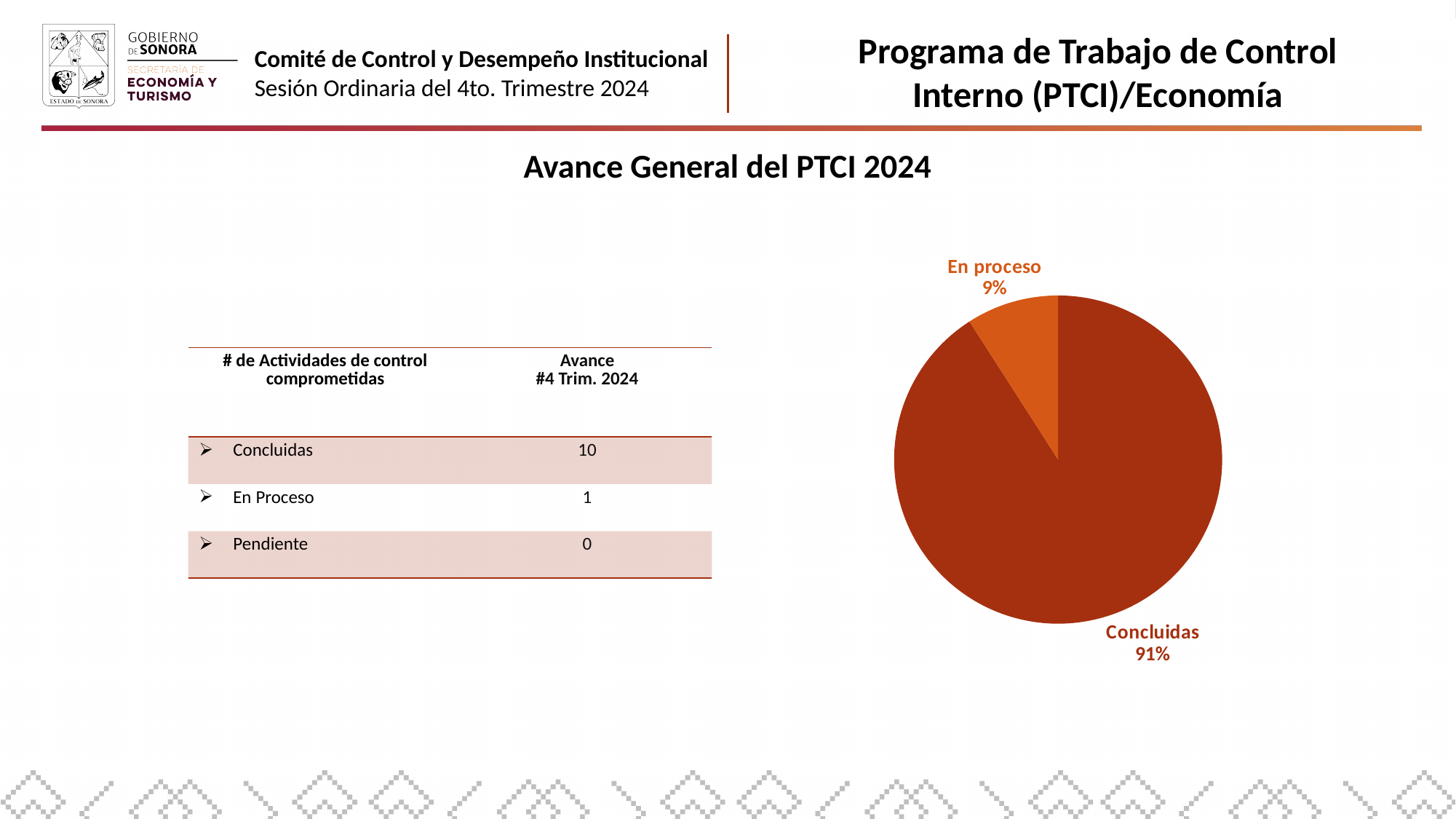
What colour is the Concluidas slice of the pie chart? dark red-brown Which slice of the pie chart is the smallest? En proceso How many slices does the pie chart have? 2 What is the difference in percentage points between the Concluidas and En proceso slices? 82 What is the title shown above the chart and table on the slide? Avance General del PTCI 2024 Is the share for Concluidas greater or less than 50%? greater What kind of chart is shown on the slide? pie chart What share of the pie chart is labelled En proceso? 9% Which slice of the pie chart is the largest? Concluidas Which is larger in the pie chart, Concluidas or En proceso? Concluidas What share of the pie chart is labelled Concluidas? 91%